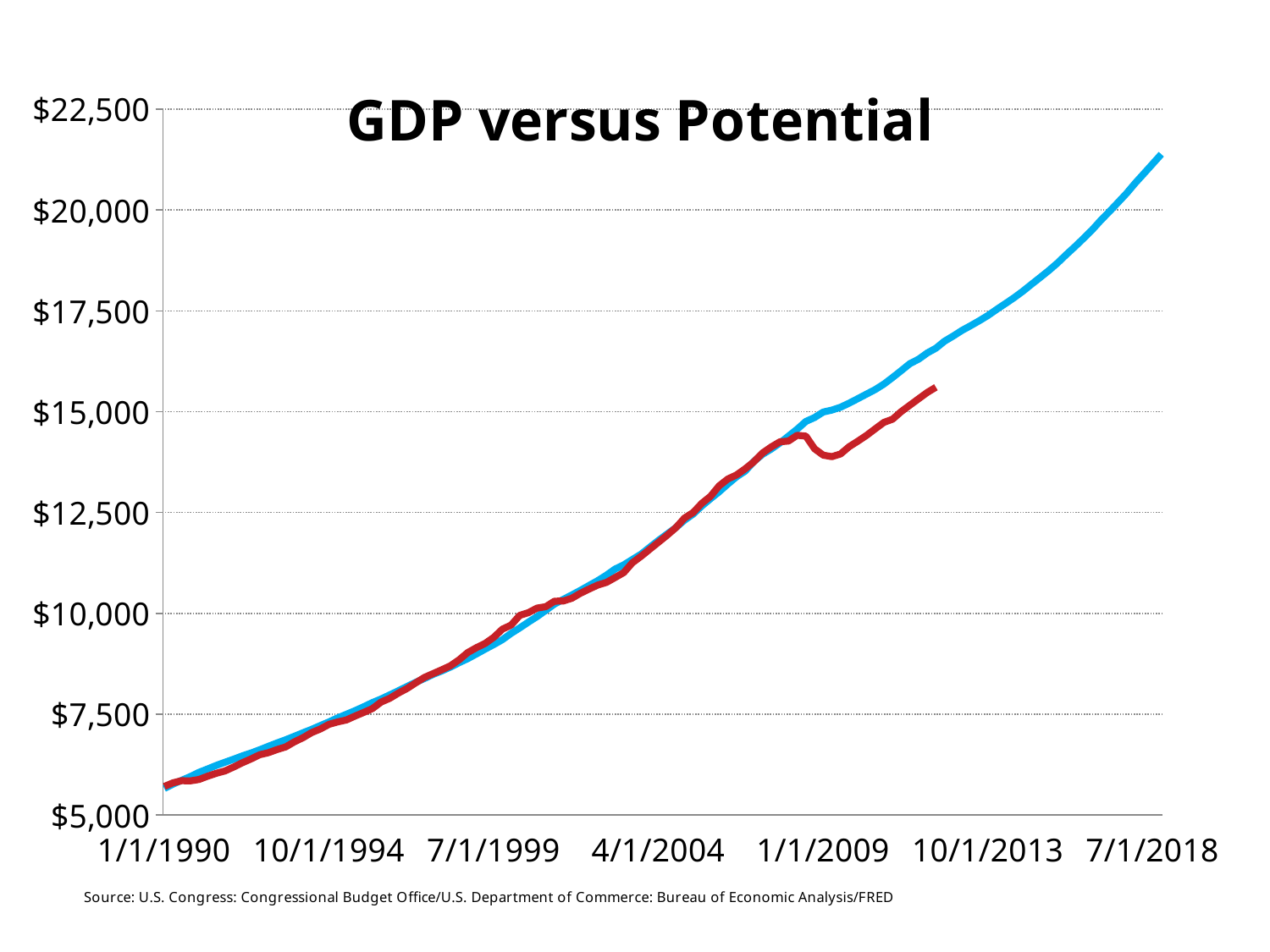
Is the value of the red line at 1/1/2009 greater or less than $15,000? less Which line reaches the highest value on the chart, the blue line or the red line? the blue line Is the value of the red line at 4/1/2004 greater or less than $12,500? less Is the value of the blue line at 1/1/1990 greater or less than $7,500? less How many date labels are shown on the x axis? 7 Around 1/1/2009, which line is higher, the blue line or the red line? the blue line What kind of chart is shown on the slide? line chart What colours are the two lines on the chart? blue and red How many lines are plotted on the chart? 2 What is the title of the chart? GDP versus Potential Do the values of the blue line rise or fall from 1/1/1990 to 7/1/2018? rise